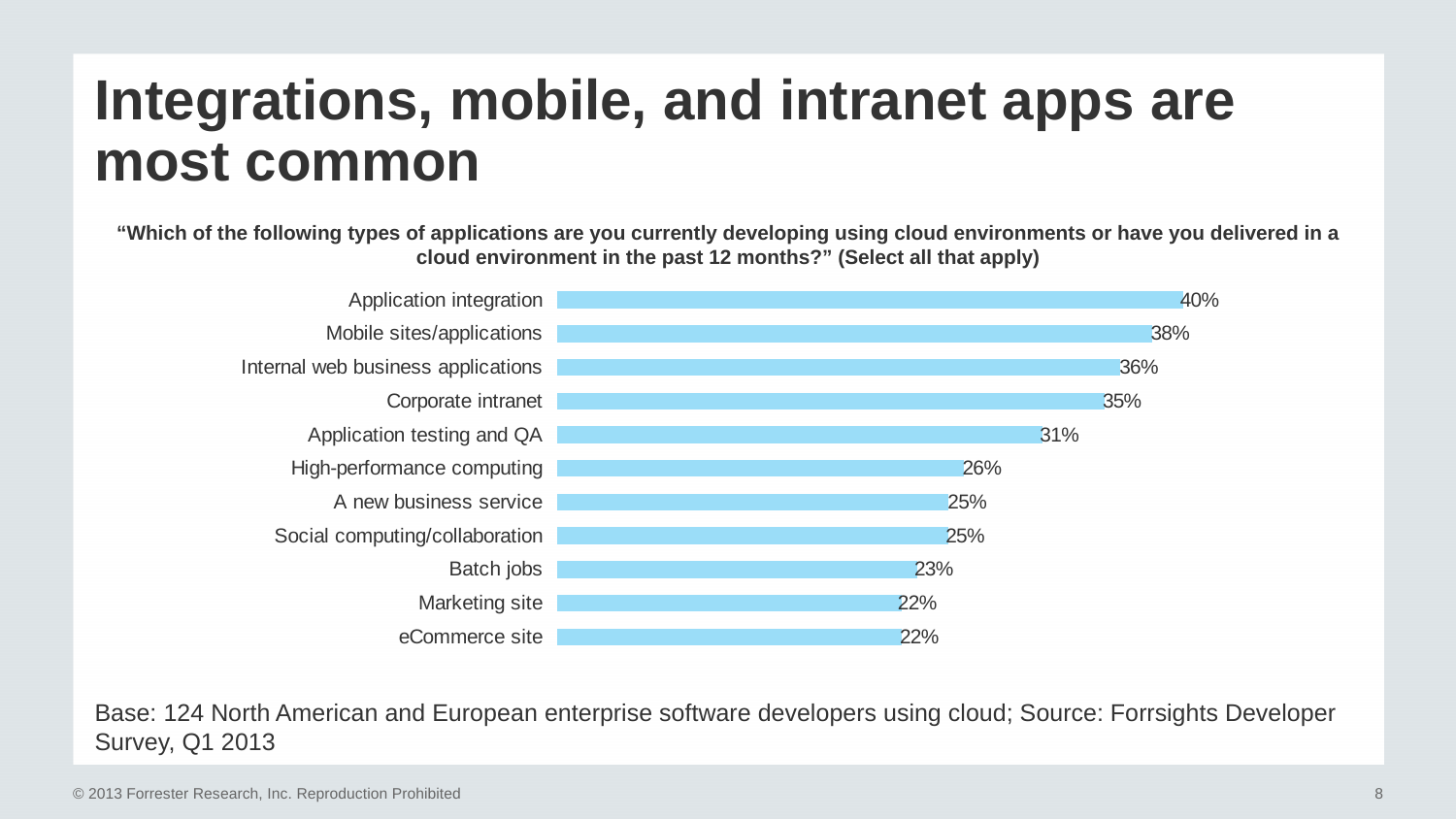
What is the value for Batch jobs? 23% What percentage of respondents are developing Application integration applications in cloud environments? 40% What is the base size of the survey cited below the chart? 124 North American and European enterprise software developers using cloud What is the difference in percentage points between Internal web business applications and Application testing and QA? 5 What is the difference in percentage points between Application integration and Mobile sites/applications? 2 What percentage is shown for Application testing and QA? 31% Which application type has the highest percentage? Application integration What is the value shown for Corporate intranet? 35% How many application types are shown in the chart? 11 Which has a higher percentage, High-performance computing or Batch jobs? High-performance computing Which application types are tied for the lowest percentage? Marketing site and eCommerce site What type of chart is shown on the slide? Bar chart